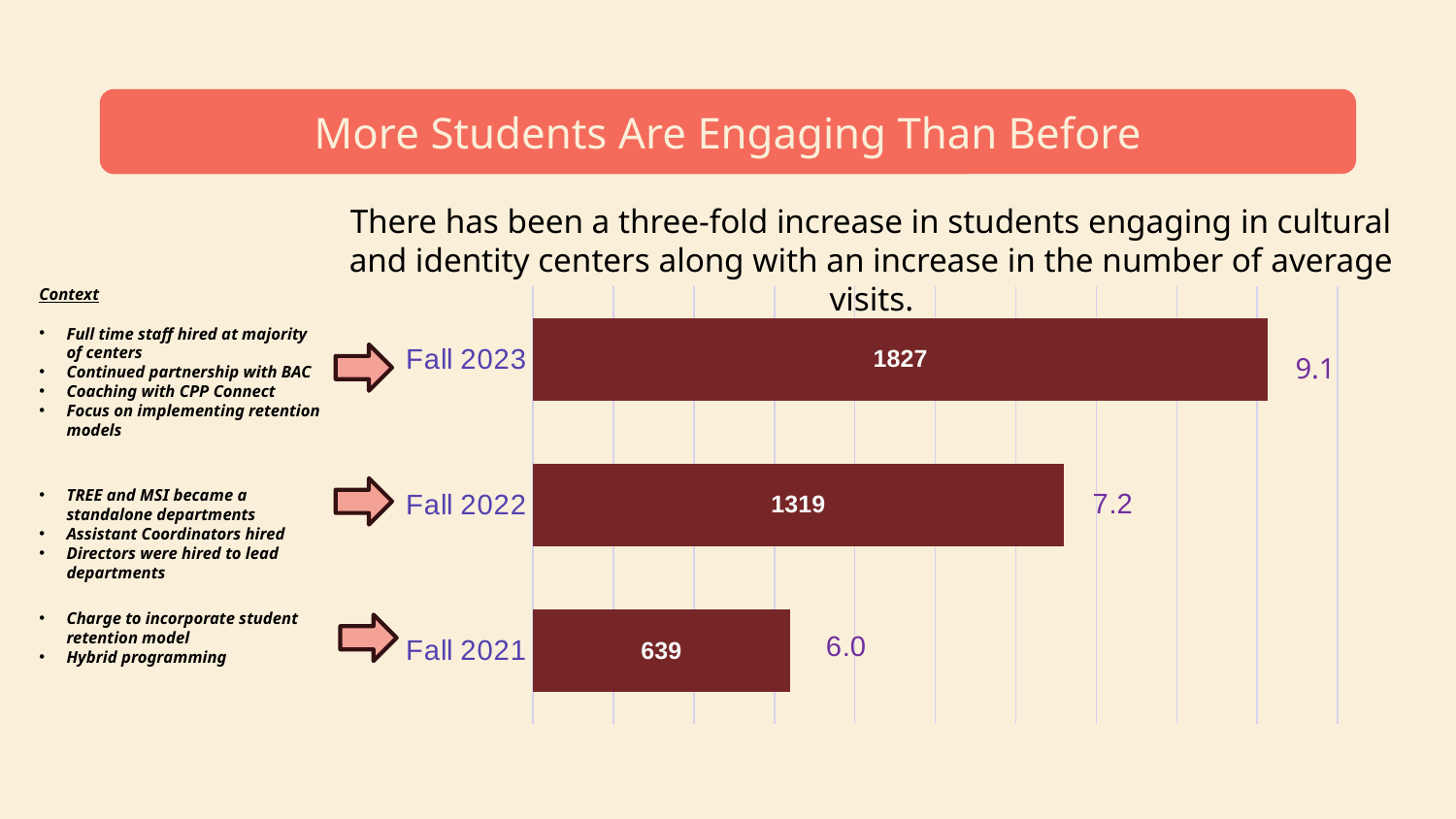
What kind of chart is shown on the slide? Bar chart What average number of visits is shown next to the Fall 2023 bar? 9.1 How many terms are shown in the chart? 3 What is the number of students engaging shown for Fall 2022? 1319 What average number of visits is shown next to the Fall 2021 bar? 6.0 Which term has the highest number of students engaging? Fall 2023 What is the difference in students engaging between Fall 2022 and Fall 2021? 680 Which has more students engaging, Fall 2022 or Fall 2021? Fall 2022 What is the number of students engaging shown for Fall 2021? 639 What is the difference in students engaging between Fall 2023 and Fall 2022? 508 Which term has the lowest number of students engaging? Fall 2021 What is the number of students engaging shown for Fall 2023? 1827